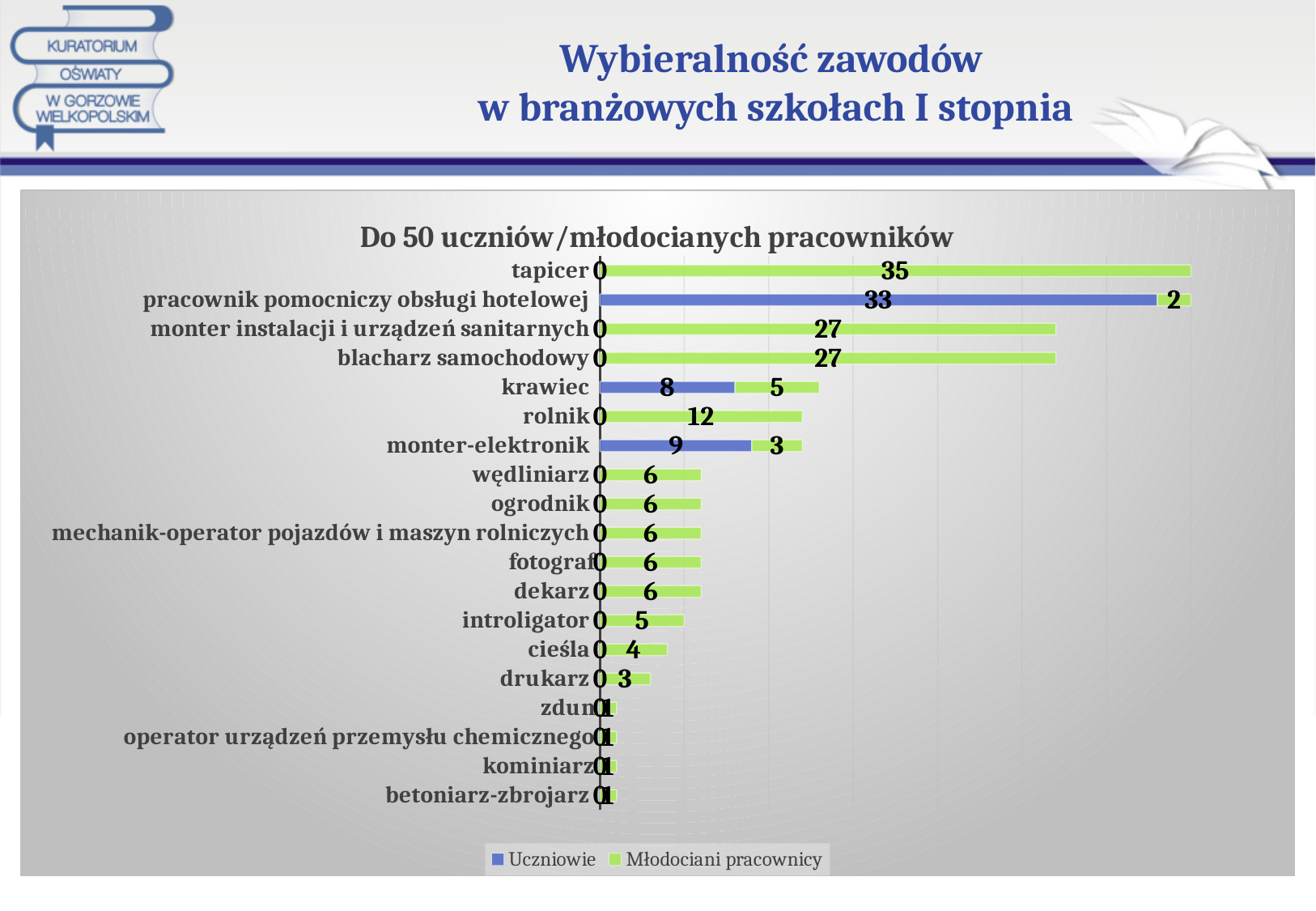
What is the total of the stacked bar for krawiec? 13 What is the value of Młodociani pracownicy for tapicer? 35 How many occupations (categories) are shown in the chart? 19 Which is larger: the Uczniowie value for krawiec or the Uczniowie value for monter-elektronik? monter-elektronik What is the value of Młodociani pracownicy for rolnik? 12 Which occupation has the highest value for Młodociani pracownicy? tapicer What kind of chart is shown on the slide? bar chart Which occupation has the highest value for Uczniowie? pracownik pomocniczy obsługi hotelowej What is the difference between the Młodociani pracownicy values for tapicer and blacharz samochodowy? 8 What is the value of Uczniowie for monter-elektronik? 9 What is the value of Uczniowie for pracownik pomocniczy obsługi hotelowej? 33 How many series does the legend list? 2